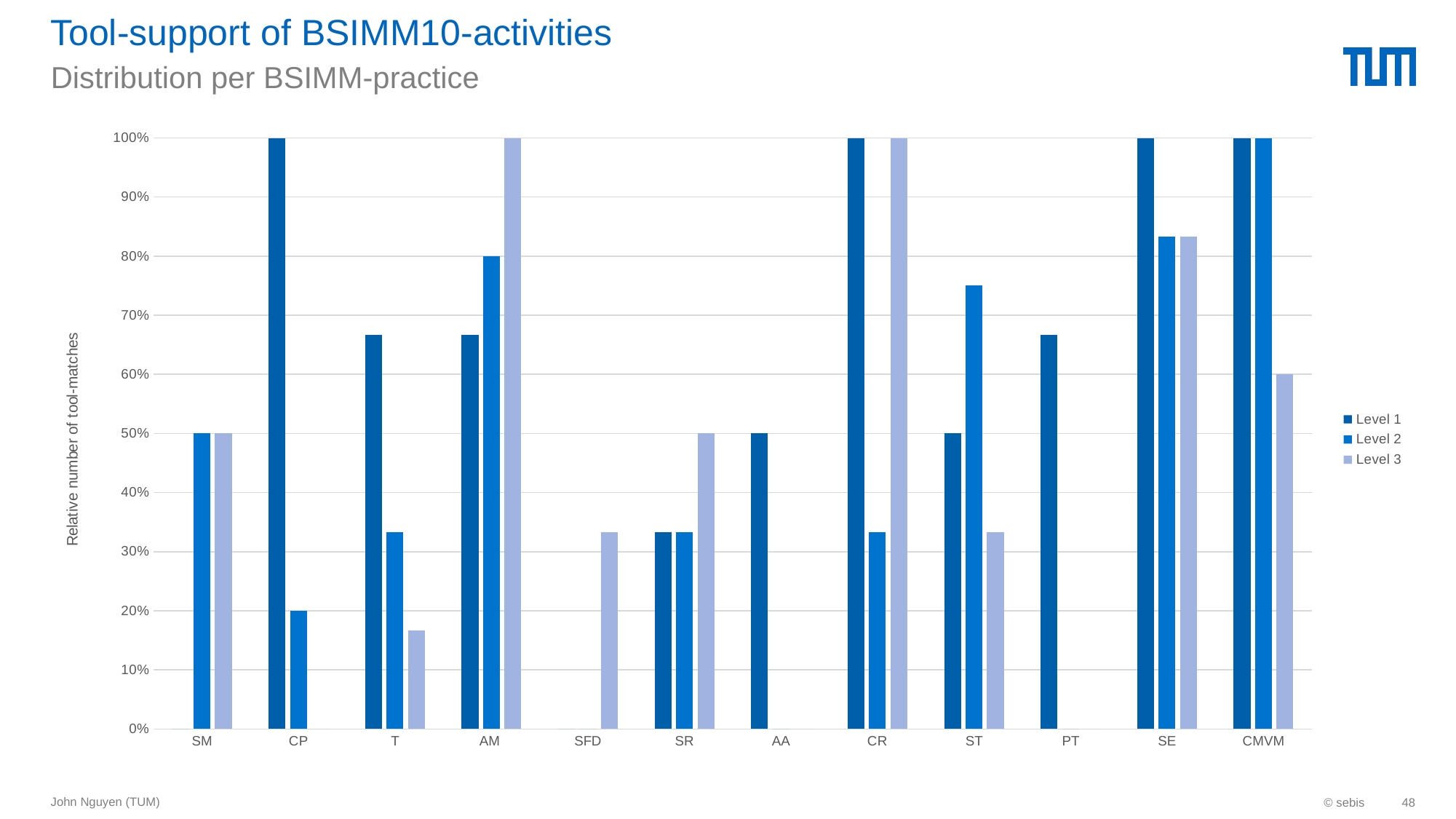
What is the Level 3 value for CMVM? 60% What is the Level 2 value for AM? 80% Is the Level 2 value for ST greater or less than 70%? greater What is the Level 2 value for CP? 20% What is the difference between the Level 1 and Level 3 values for CMVM? 40 percentage points What kind of chart is shown on the slide? bar chart Which is larger, the Level 2 value for AM or the Level 2 value for CP? AM How many series does the legend list? 3 Is the Level 3 value for T greater or less than 20%? less What is the Level 1 value for AA? 50% What is the Level 1 value for CP? 100% How many BSIMM practices are shown on the x axis? 12